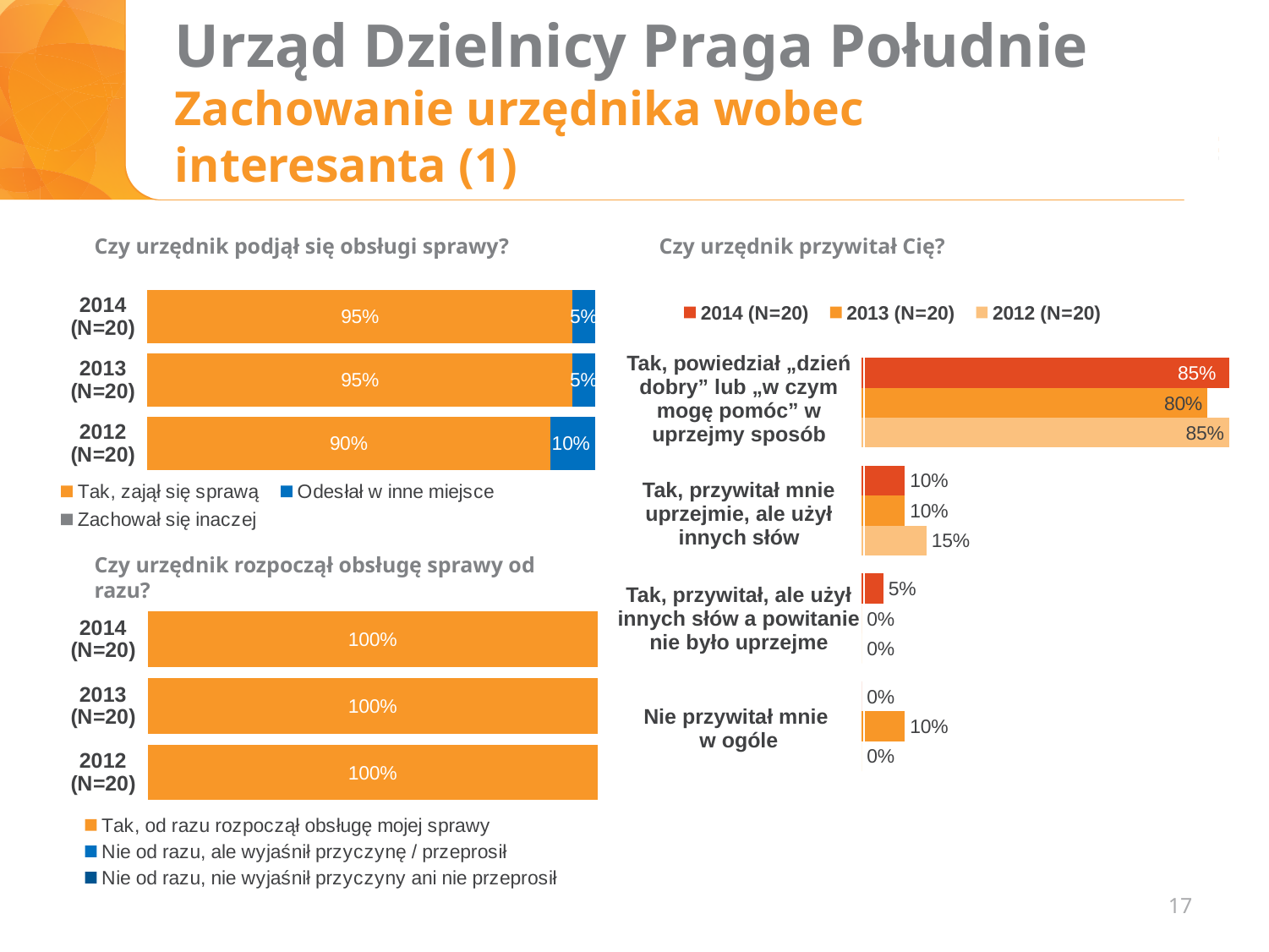
In the chart 'Czy urzędnik przywitał Cię?', what is the value for 2013 (N=20) in the category 'Tak, powiedział „dzień dobry” lub „w czym mogę pomóc” w uprzejmy sposób'? 80% In the chart 'Czy urzędnik podjął się obsługi sprawy?', how many series does the legend list? 3 In the chart 'Czy urzędnik podjął się obsługi sprawy?', what is the value of 'Odesłał w inne miejsce' for 2012 (N=20)? 10% In the chart 'Czy urzędnik przywitał Cię?', which is larger for the category 'Tak, powiedział „dzień dobry” lub „w czym mogę pomóc” w uprzejmy sposób': the 2014 (N=20) value or the 2013 (N=20) value? 2014 (N=20) In the chart 'Czy urzędnik podjął się obsługi sprawy?', what is the difference between the 'Tak, zajął się sprawą' values for 2014 (N=20) and 2012 (N=20)? 5% In the chart 'Czy urzędnik podjął się obsługi sprawy?', which year has the lowest value for 'Tak, zajął się sprawą'? 2012 (N=20) In the chart 'Czy urzędnik rozpoczął obsługę sprawy od razu?', what is the value of 'Tak, od razu rozpoczął obsługę mojej sprawy' for 2013 (N=20)? 100% In the chart 'Czy urzędnik rozpoczął obsługę sprawy od razu?', how many year categories are shown? 3 In the chart 'Czy urzędnik przywitał Cię?', what is the value for 2012 (N=20) in the category 'Tak, przywitał mnie uprzejmie, ale użył innych słów'? 15% In the chart 'Czy urzędnik przywitał Cię?', which series has a non-zero value in the category 'Nie przywitał mnie w ogóle'? 2013 (N=20) In the chart 'Czy urzędnik podjął się obsługi sprawy?', what is the value of 'Tak, zajął się sprawą' for 2012 (N=20)? 90% What kind of chart is 'Czy urzędnik przywitał Cię?'? Bar chart